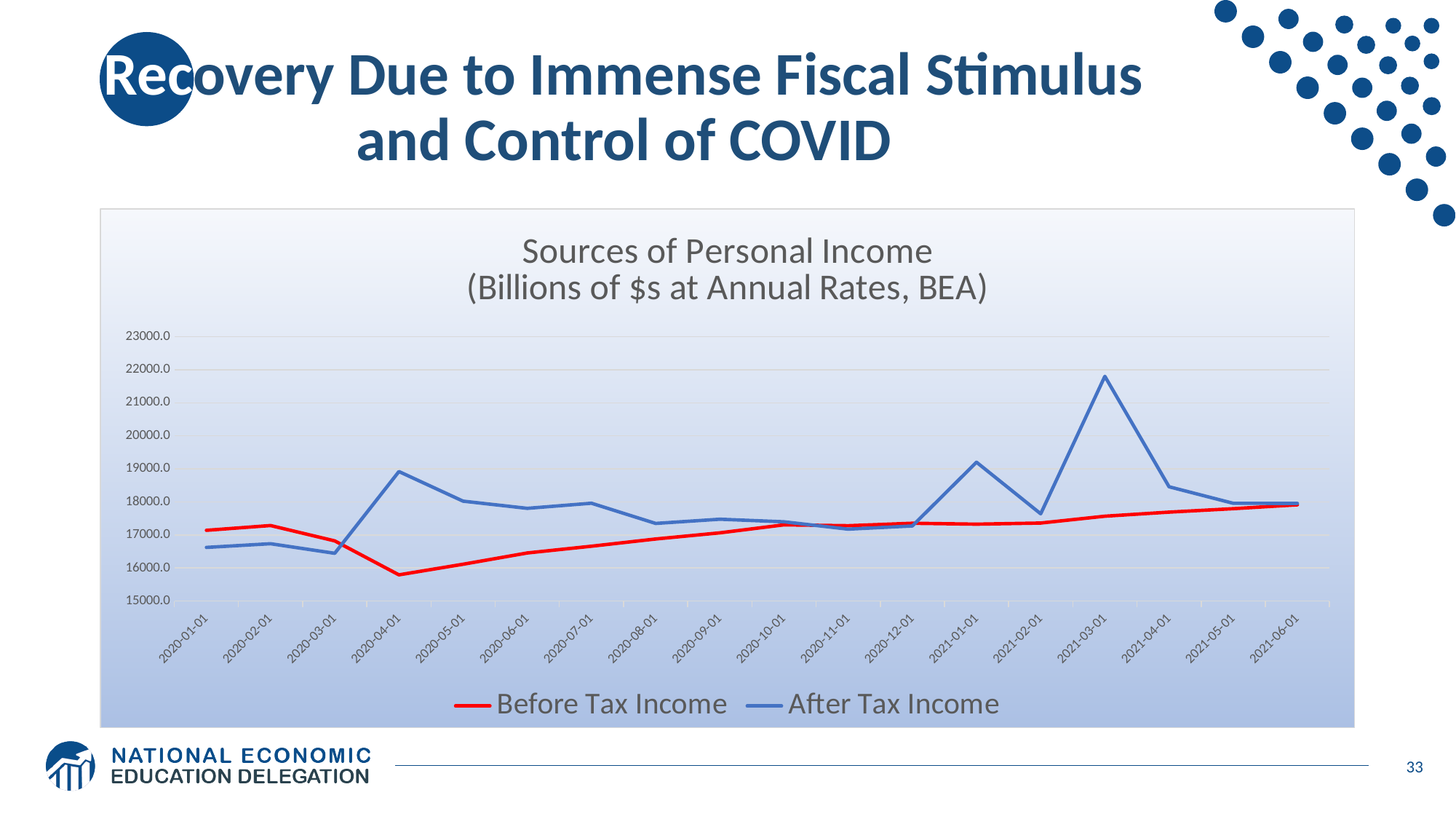
Is the After Tax Income value for 2021-03-01 greater or less than 21000.0? greater Does Before Tax Income generally rise or fall from 2020-04-01 to 2021-06-01? rise How many dates are plotted along the x axis? 18 What is the title of the chart? Sources of Personal Income (Billions of $s at Annual Rates, BEA) What kind of chart is shown on the slide? line chart On which date does Before Tax Income reach its lowest value? 2020-04-01 On which date does After Tax Income reach its highest value? 2021-03-01 Is the After Tax Income value for 2021-01-01 greater or less than 18000.0? greater At 2020-04-01, which series has the higher value, Before Tax Income or After Tax Income? After Tax Income At 2020-01-01, which series has the higher value, Before Tax Income or After Tax Income? Before Tax Income How many series does the legend list? 2 Is the Before Tax Income value for 2020-04-01 greater or less than 16000.0? less